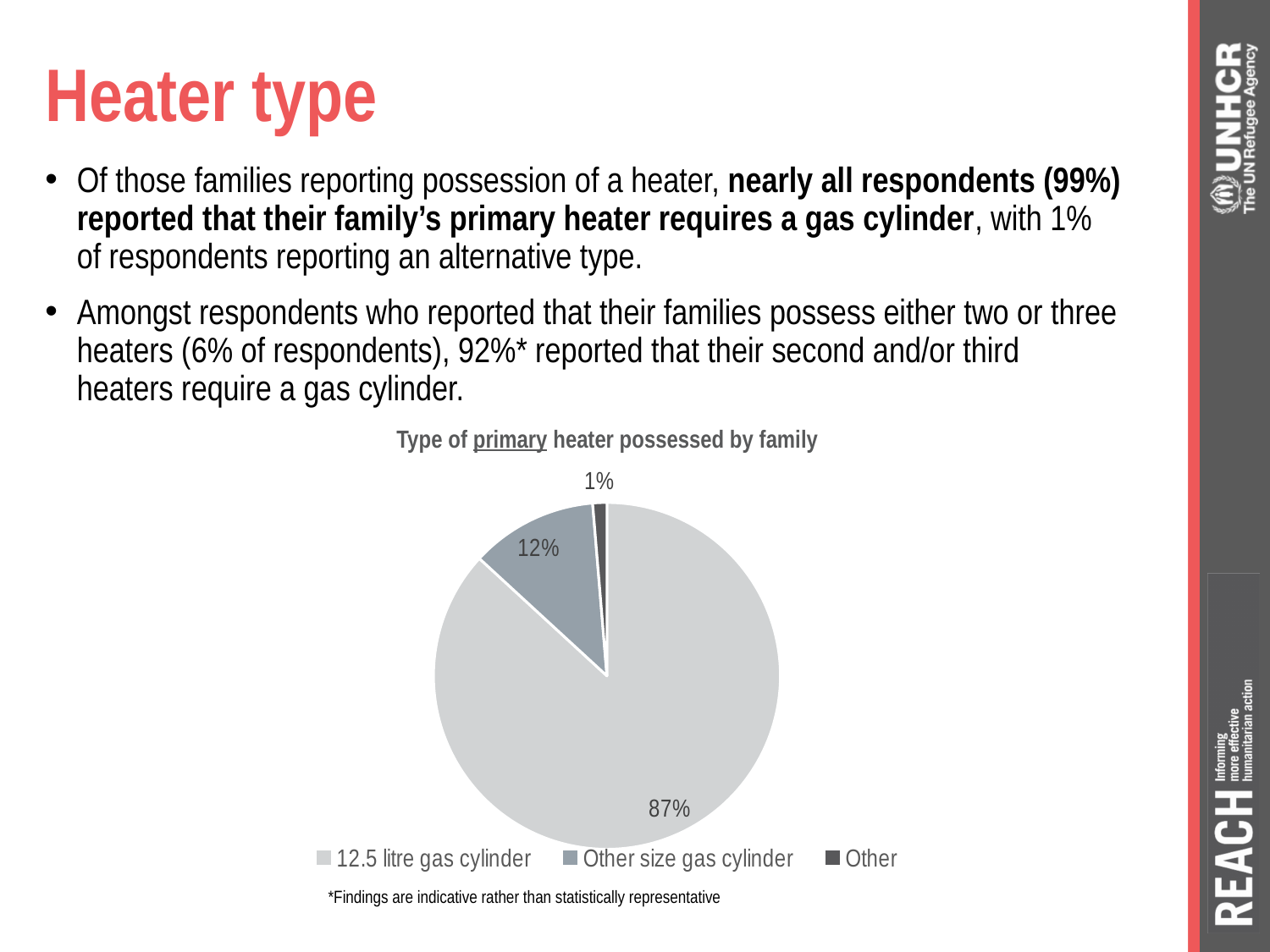
Which heater type has the smallest share of the pie? Other Which is larger: the share for other size gas cylinder or the share for Other? Other size gas cylinder What is the title of the chart? Type of primary heater possessed by family What kind of chart is shown on the slide? pie chart What is the combined share of the two gas cylinder categories? 99% What share of families have an 'Other' type of primary heater? 1% How many entries does the legend list? 3 How many slices does the pie chart have? 3 Which heater type has the largest share of the pie? 12.5 litre gas cylinder What share of families have an other size gas cylinder as their primary heater? 12% What share of families have a 12.5 litre gas cylinder as their primary heater? 87% What is the difference in percentage points between the 12.5 litre gas cylinder share and the other size gas cylinder share? 75 percentage points